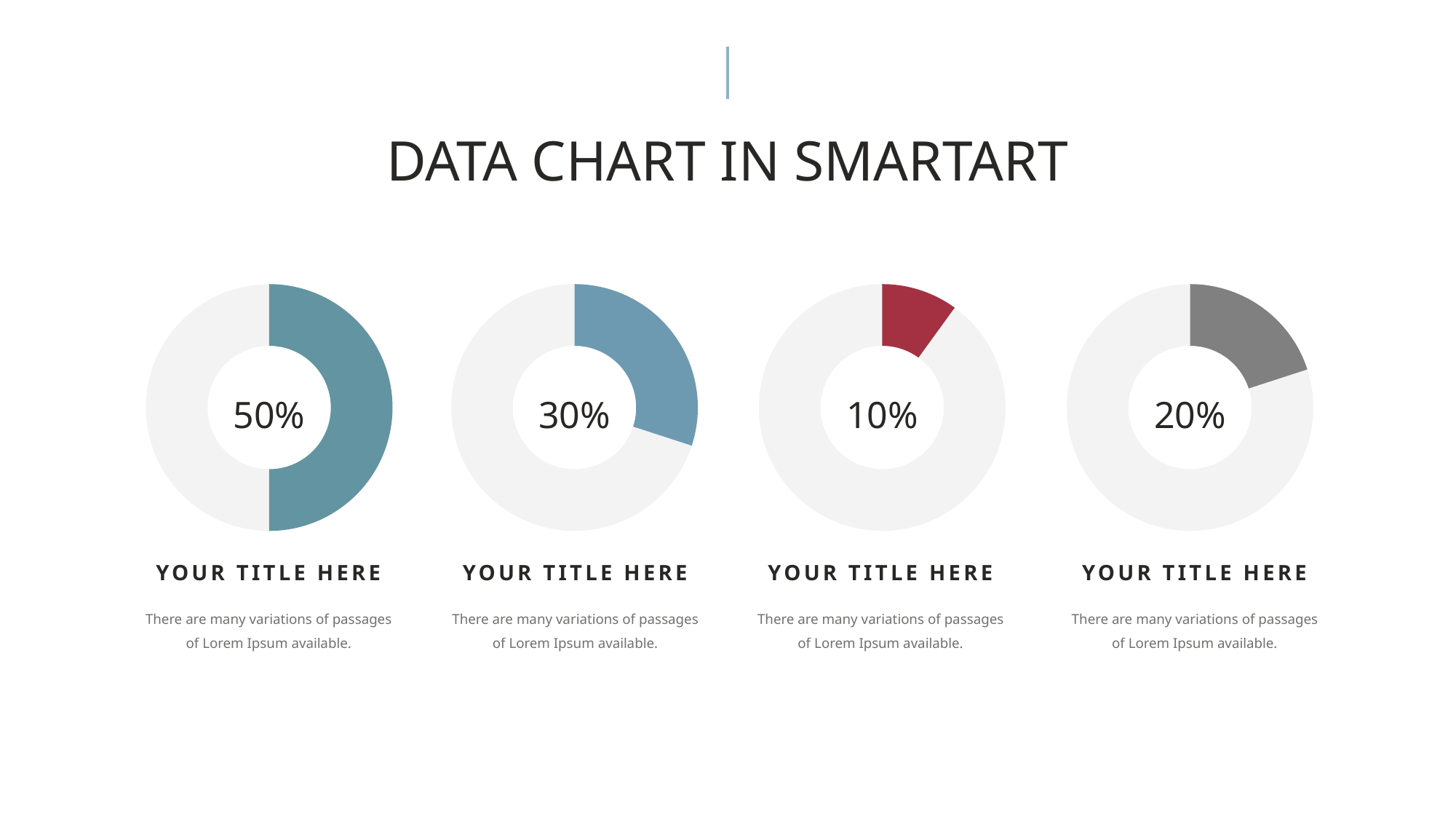
Which donut chart on the slide shows the lowest percentage? The third chart from the left (10%) What kind of chart is used on this slide? Donut chart What is the title of the slide? DATA CHART IN SMARTART Which is larger: the percentage in the second donut chart or the percentage in the rightmost donut chart? The second donut chart (30%) What value is shown in the centre of the second donut chart from the left? 30% What colour is the filled segment of the third donut chart from the left? Red Which donut chart on the slide shows the highest percentage? The leftmost chart (50%) What value is shown in the centre of the rightmost donut chart? 20% How many donut charts are on the slide? 4 What is the difference between the percentage in the leftmost donut chart and the percentage in the rightmost donut chart? 30% What value is shown in the centre of the third donut chart from the left? 10% What value is shown in the centre of the leftmost donut chart? 50%